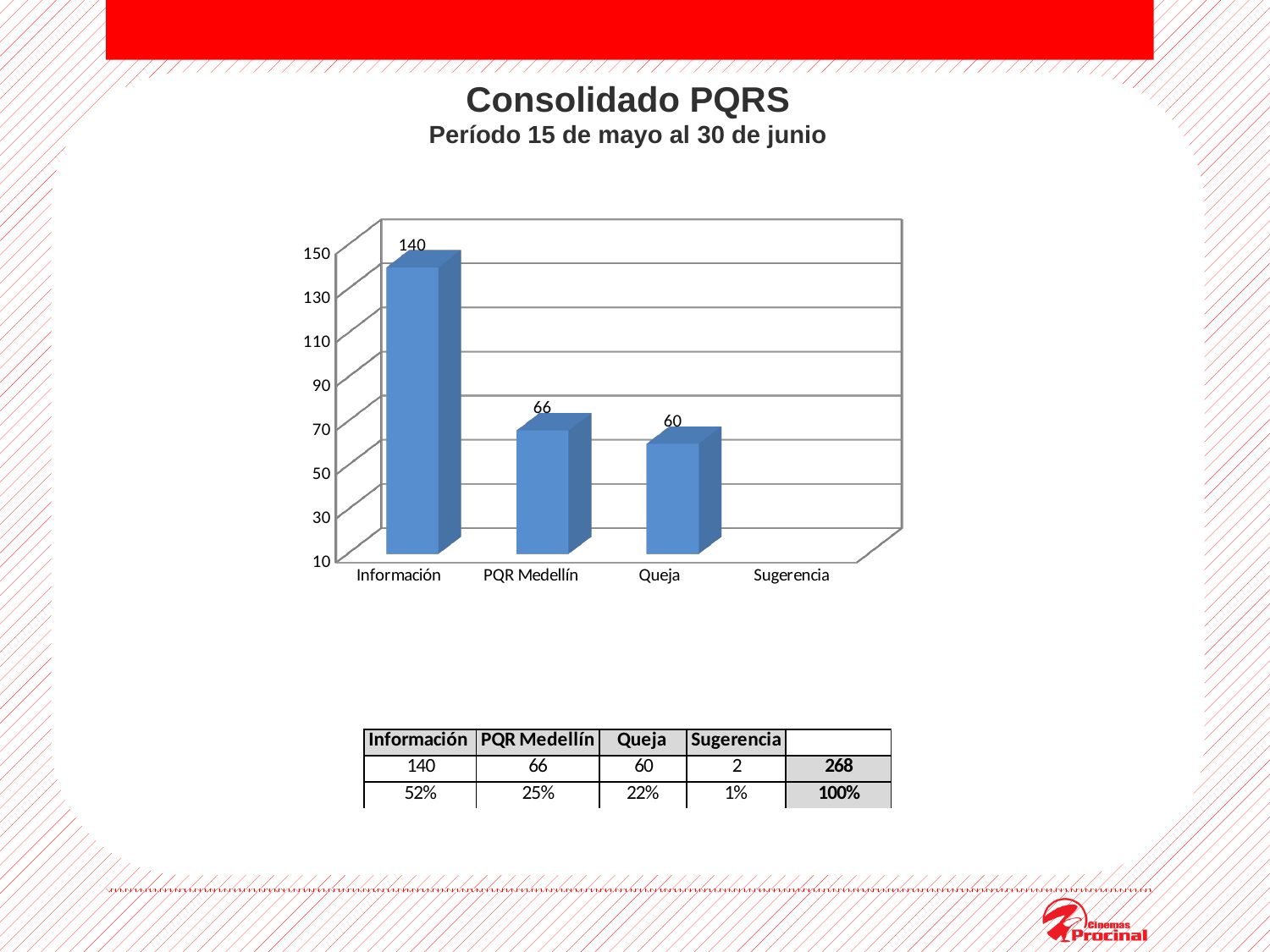
What is the difference between the values for PQR Medellín and Queja? 6 What is the title of the slide above the chart? Consolidado PQRS What is the value for Queja? 60 What kind of chart is shown on the slide? bar chart How many categories are shown on the x axis of the chart? 4 What is the value for Información? 140 Is the value for Información greater or less than 130? greater What is the difference between the values for Información and PQR Medellín? 74 Which is larger, the value for Información or the value for Queja? Información What is the value for PQR Medellín? 66 Which category has the highest value? Información Is the value for Queja greater or less than 70? less